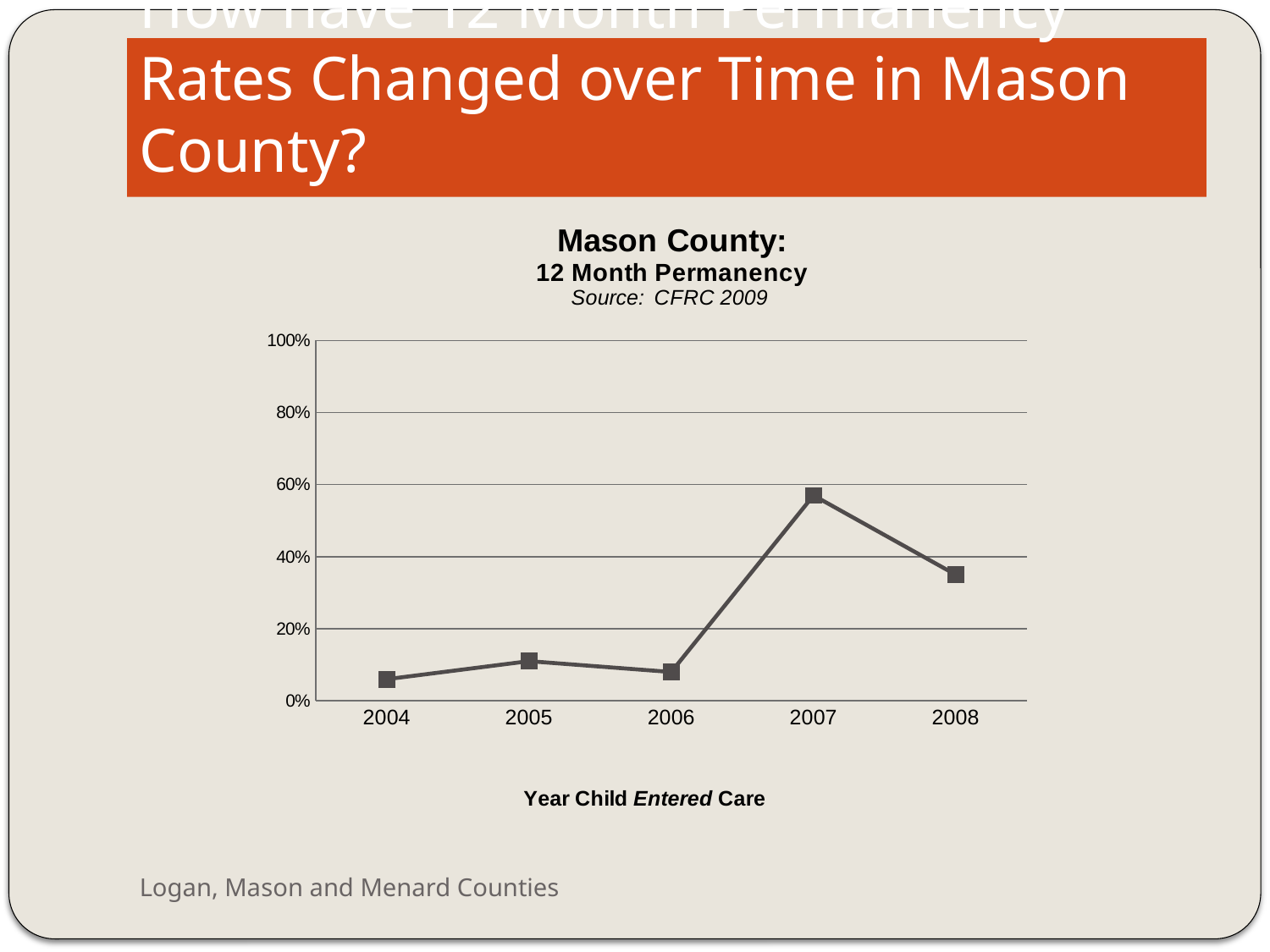
Does the value rise or fall from 2006 to 2007? rise Which year has the larger value, 2007 or 2008? 2007 Is the value for 2008 greater or less than 20%? greater What kind of chart is shown on the slide? Line chart Is the value for 2007 greater or less than 40%? greater Is the value for 2006 greater or less than 20%? less What is the x axis title of the chart? Year Child Entered Care Does the value rise or fall from 2007 to 2008? fall Which year has the highest 12 month permanency rate? 2007 How many years are plotted on the x axis of the chart? 5